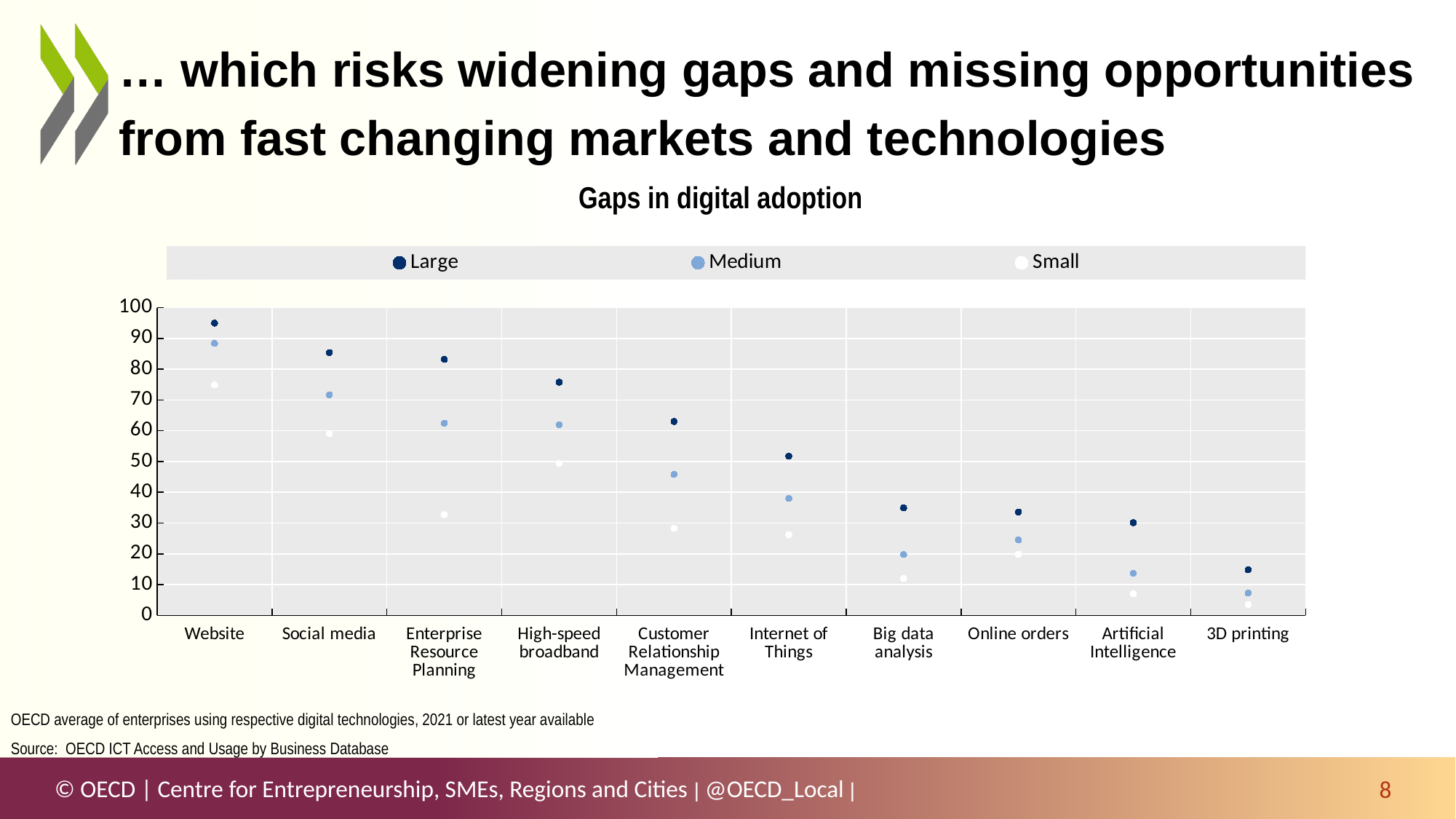
Is the Medium value for Customer Relationship Management greater or less than 50? less Which category has the highest value for the Large series? Website What kind of chart is shown on the slide? scatter chart What is the title of the chart? Gaps in digital adoption For the Medium series, which is larger: Social media or Enterprise Resource Planning? Social media How many series does the legend list? 3 How many technology categories are shown on the x axis? 10 Do the Large series values rise or fall moving from left to right along the x axis? fall Which category has the lowest value for the Small series? 3D printing Is the Small value for Enterprise Resource Planning greater or less than 40? less Is the Large value for Website greater or less than 90? greater For the Small series, which is larger: Social media or High-speed broadband? Social media